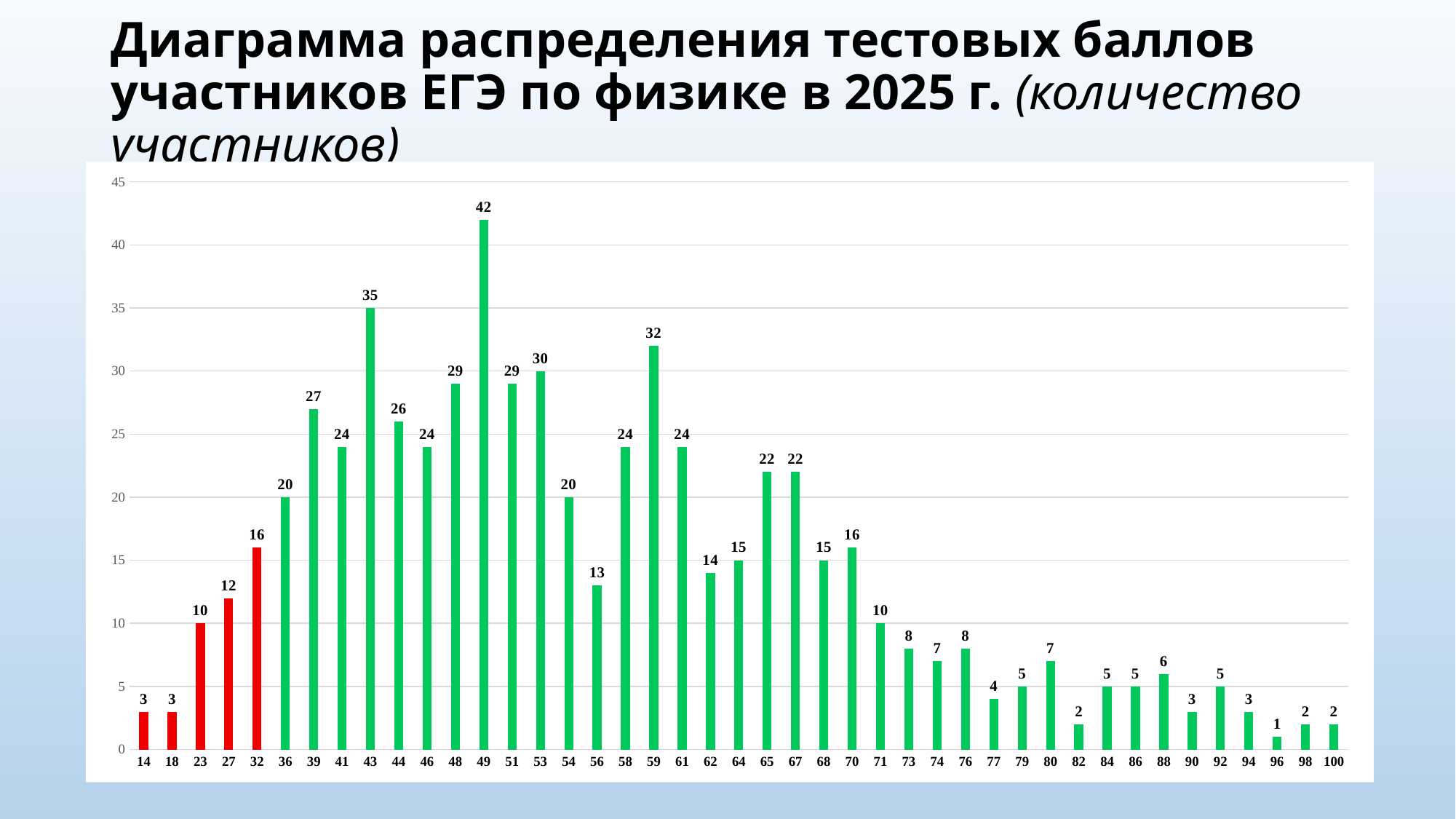
How many bars are coloured red? 5 Which test score has the lowest number of participants? 96 Which test score has the highest number of participants? 49 Which has more participants: score 59 or score 53? 59 How many participants scored 32 test points? 16 How many participants scored 49 test points? 42 What is the difference between the number of participants with score 65 and with score 71? 12 What kind of chart is shown on the slide? bar chart How many participants scored 100 test points? 2 What is the difference between the number of participants with score 49 and with score 43? 7 Do the values generally rise or fall along the x axis from score 61 to score 100? fall How many score categories are shown on the x axis? 43